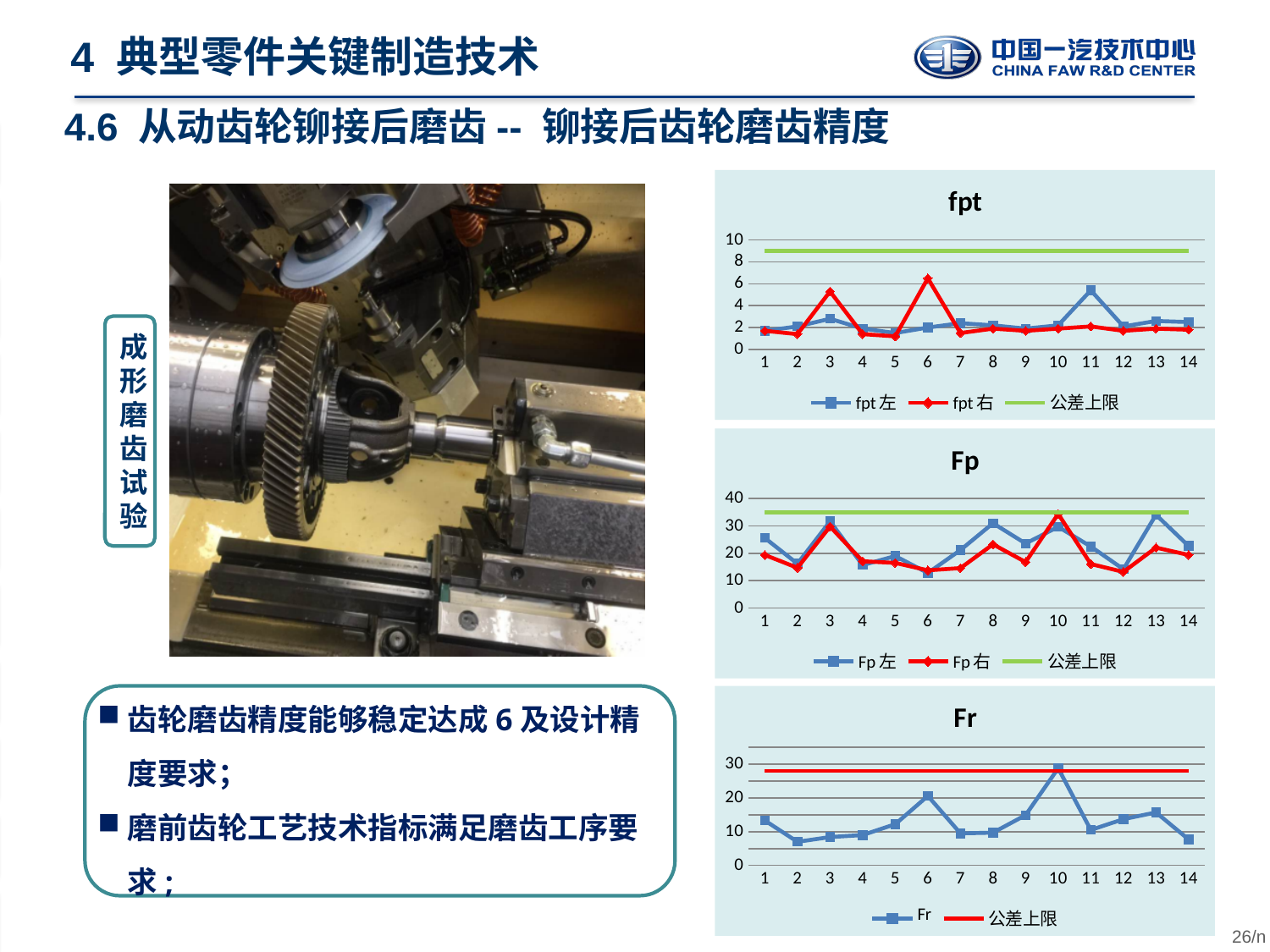
How many series does the legend of the "Fr" chart list? 2 In the "Fr" chart, is the value of "Fr" at point 2 greater or less than 10? less In the "Fp" chart, is the value of "Fp左" at point 6 greater or less than 20? less In the "Fp" chart, at which x-axis point does the "Fp右" series reach its highest value? 10 How many series does the legend of the "Fp" chart list? 3 In the "fpt" chart, is the value of "fpt左" at point 11 greater or less than 4? greater What kind of chart is the chart titled "fpt"? line chart How many series does the legend of the "fpt" chart list? 3 How many points are plotted along the x axis of the "fpt" chart? 14 In the "fpt" chart, at which x-axis point does the "fpt右" series reach its highest value? 6 In the "Fr" chart, at which x-axis point does the "Fr" series reach its highest value? 10